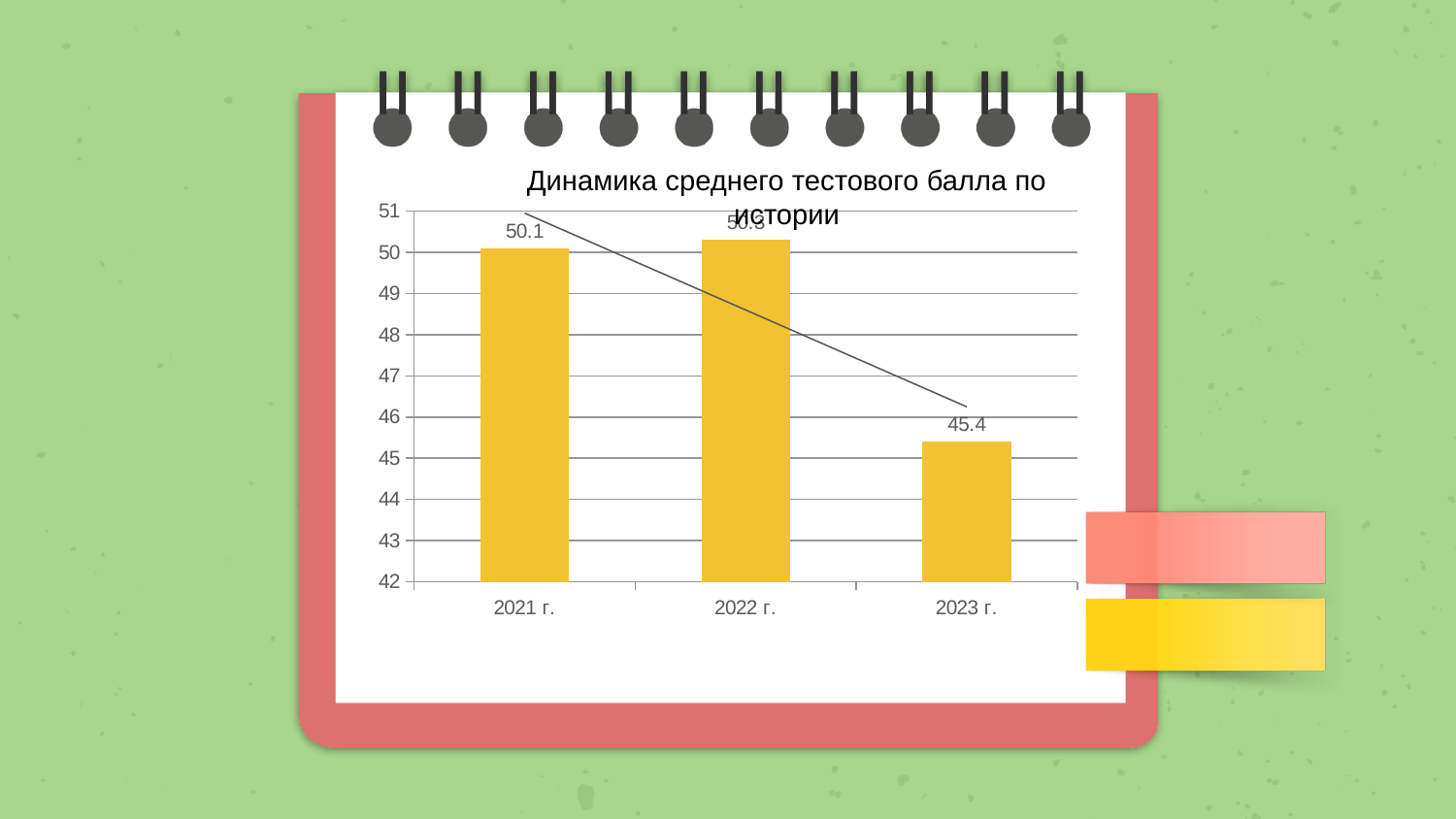
What is the value for 2021 г.? 50.1 What is the title of the chart? Динамика среднего тестового балла по истории What is the value for 2023 г.? 45.4 Which year has the lowest value? 2023 г. What is the difference between the values for 2021 г. and 2023 г.? 4.7 What colour are the bars? yellow Which is larger, the value for 2021 г. or the value for 2023 г.? 2021 г. Does the trend line show values rising or falling from 2021 г. to 2023 г.? falling How many years are shown on the x axis? 3 What kind of chart is this? bar chart Is the value for 2023 г. greater or less than 46? less Is the value for 2022 г. greater or less than 49? greater